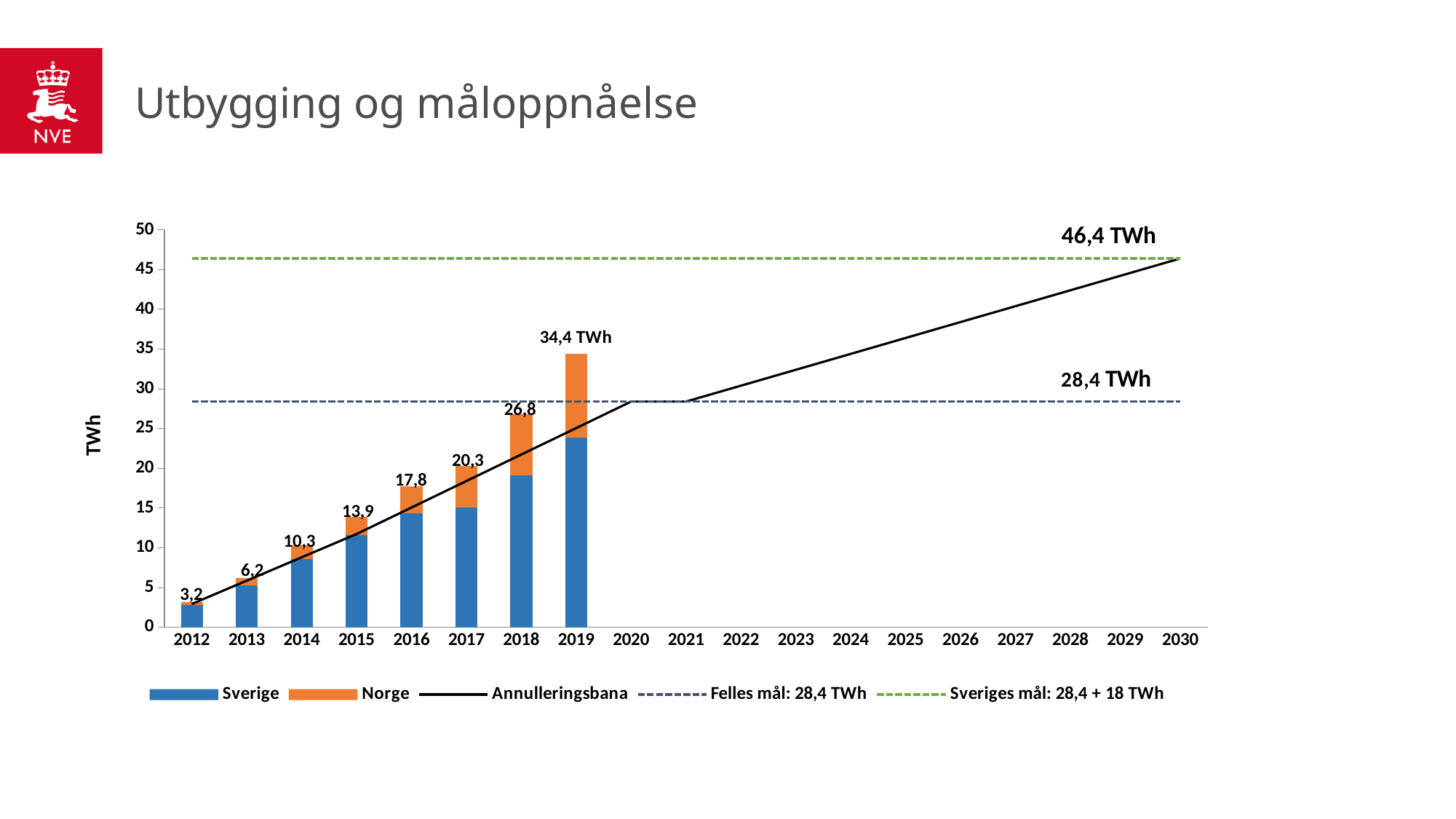
What is the total value labelled on the bar for 2015? 13,9 What is the total value labelled on the bar for 2019? 34,4 TWh How many years have stacked bars plotted? 8 What is the total value labelled on the bar for 2012? 3,2 Do the bar totals rise or fall from 2012 to 2019? Rise Is the Sverige value for 2019 greater or less than 20? greater Which year has the lowest stacked bar total? 2012 How many entries does the legend list? 5 What is the difference between the bar totals for 2019 and 2018? 7,6 Which year has the highest stacked bar total? 2019 Which year has a larger bar total, 2016 or 2017? 2017 What kind of chart is shown on the slide? Stacked bar chart with line overlays